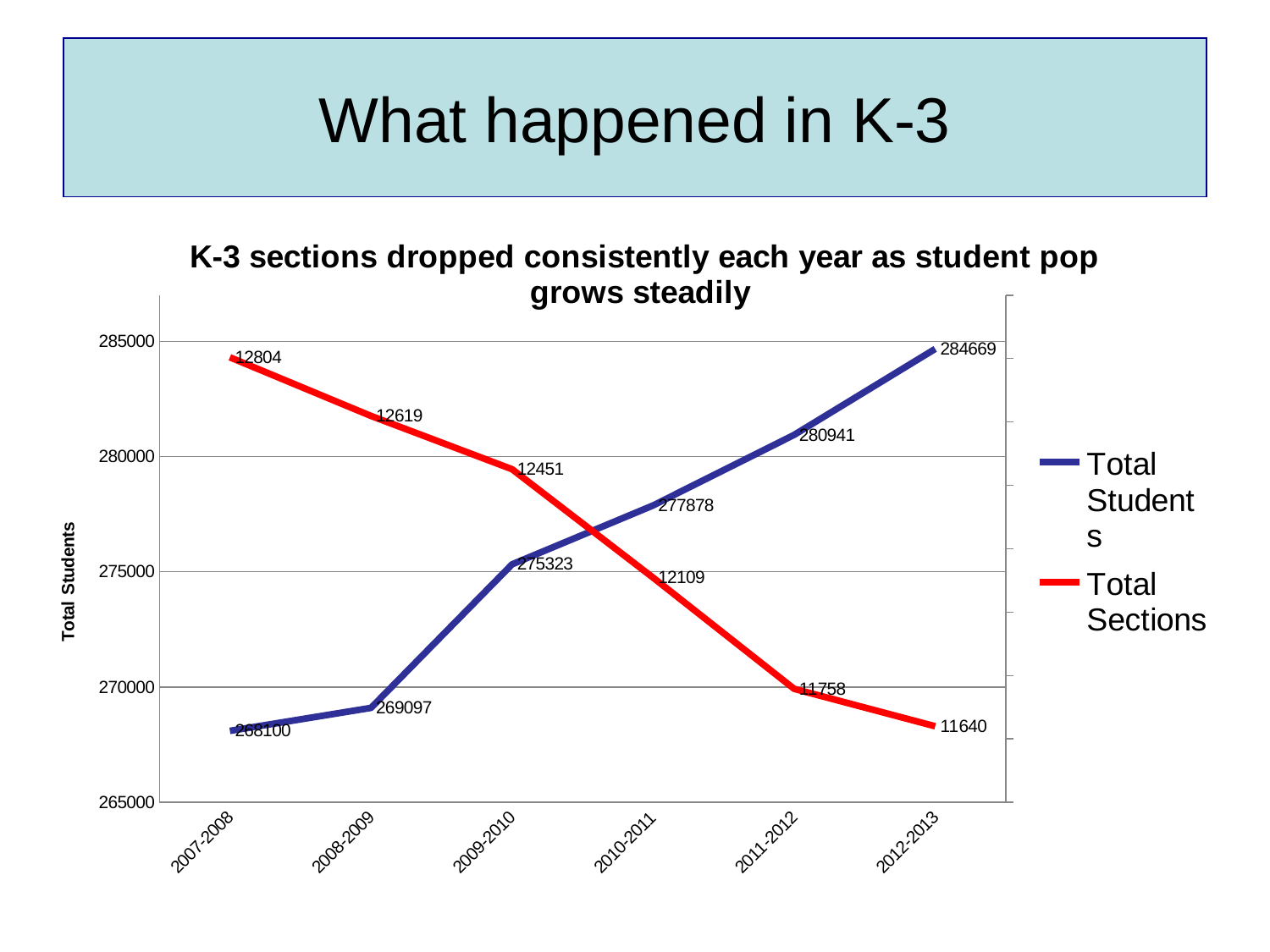
How many school years are plotted along the x axis? 6 What is the value of Total Students for 2012-2013? 284669 How many series does the legend list? 2 What kind of chart is shown on the slide? Line chart In which school year is Total Students highest? 2012-2013 What is the value of Total Students for 2009-2010? 275323 Does Total Sections rise or fall across the school years from 2007-2008 to 2012-2013? Fall What is the value of Total Sections for 2011-2012? 11758 What is the value of Total Sections for 2007-2008? 12804 What is the difference between Total Students in 2012-2013 and 2011-2012? 3728 In which school year is Total Sections lowest? 2012-2013 Which colour is used for the Total Sections line? Red